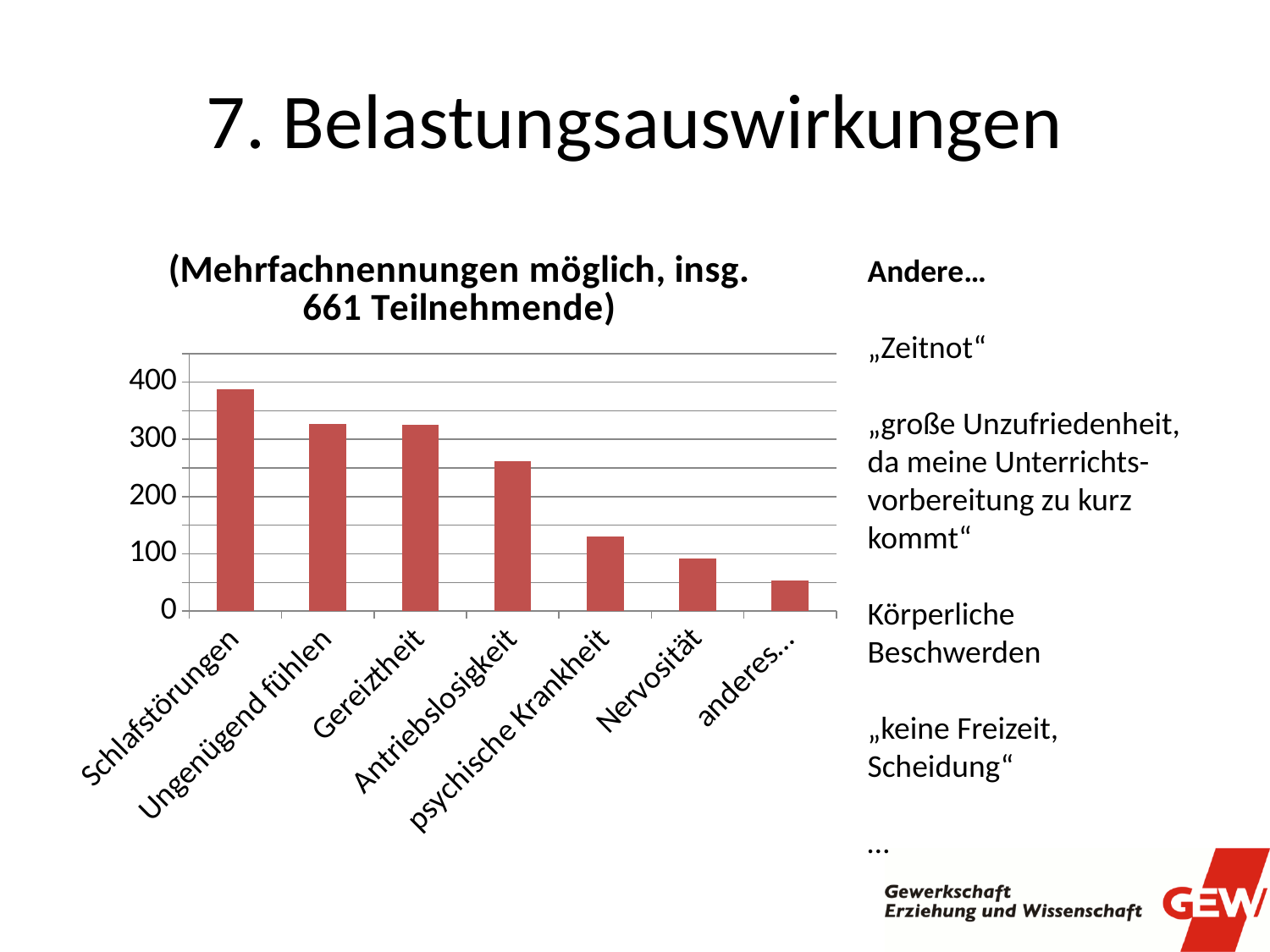
Is the value for psychische Krankheit greater or less than 100? greater What kind of chart is shown on the slide? bar chart What is the title of the chart? (Mehrfachnennungen möglich, insg. 661 Teilnehmende) Which category has the lowest value in the chart? anderes... Do the values rise or fall from left to right along the x axis? fall Is the value for Schlafstörungen greater or less than 300? greater How many categories are shown on the x axis of the chart? 7 Which is larger, the value for Schlafstörungen or the value for Antriebslosigkeit? Schlafstörungen Which category has the highest value in the chart? Schlafstörungen Is the value for Antriebslosigkeit greater or less than 300? less